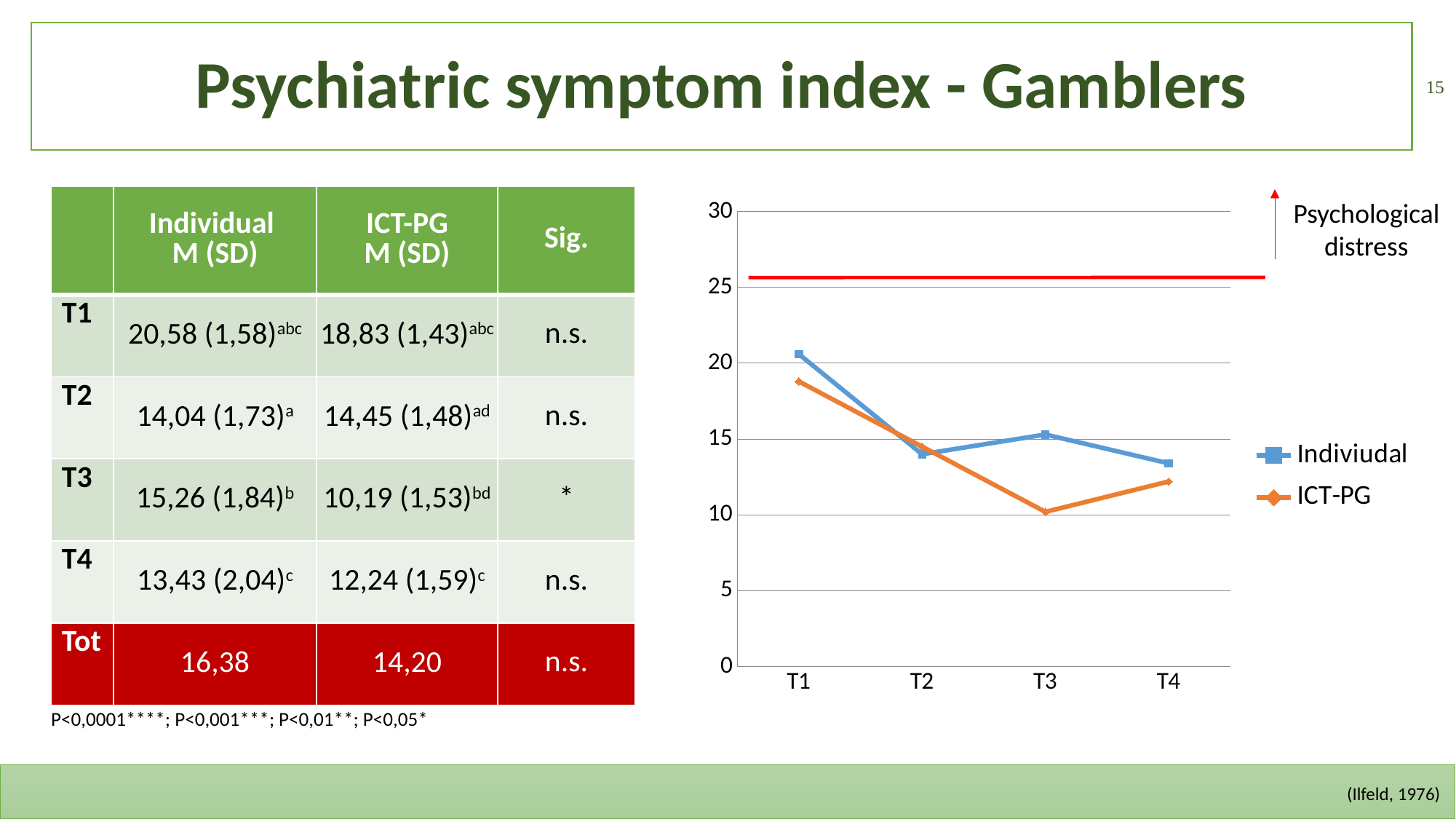
At which time point is the ICT-PG line at its highest? T1 How many time points are plotted along the x axis of the chart? 4 At which time point is the ICT-PG line at its lowest? T3 At T3, which series has the higher value, Indiviudal or ICT-PG? Indiviudal At which time point is the Indiviudal line at its highest? T1 Does the ICT-PG line rise or fall from T1 to T3? fall What label is written next to the red arrow above the chart? Psychological distress Is the value for ICT-PG at T1 greater or less than 15? greater What kind of chart is shown on the right of the slide? line chart Is the value for Indiviudal at T4 greater or less than 15? less How many series does the chart's legend list? 2 Is the value for ICT-PG at T3 greater or less than 15? less